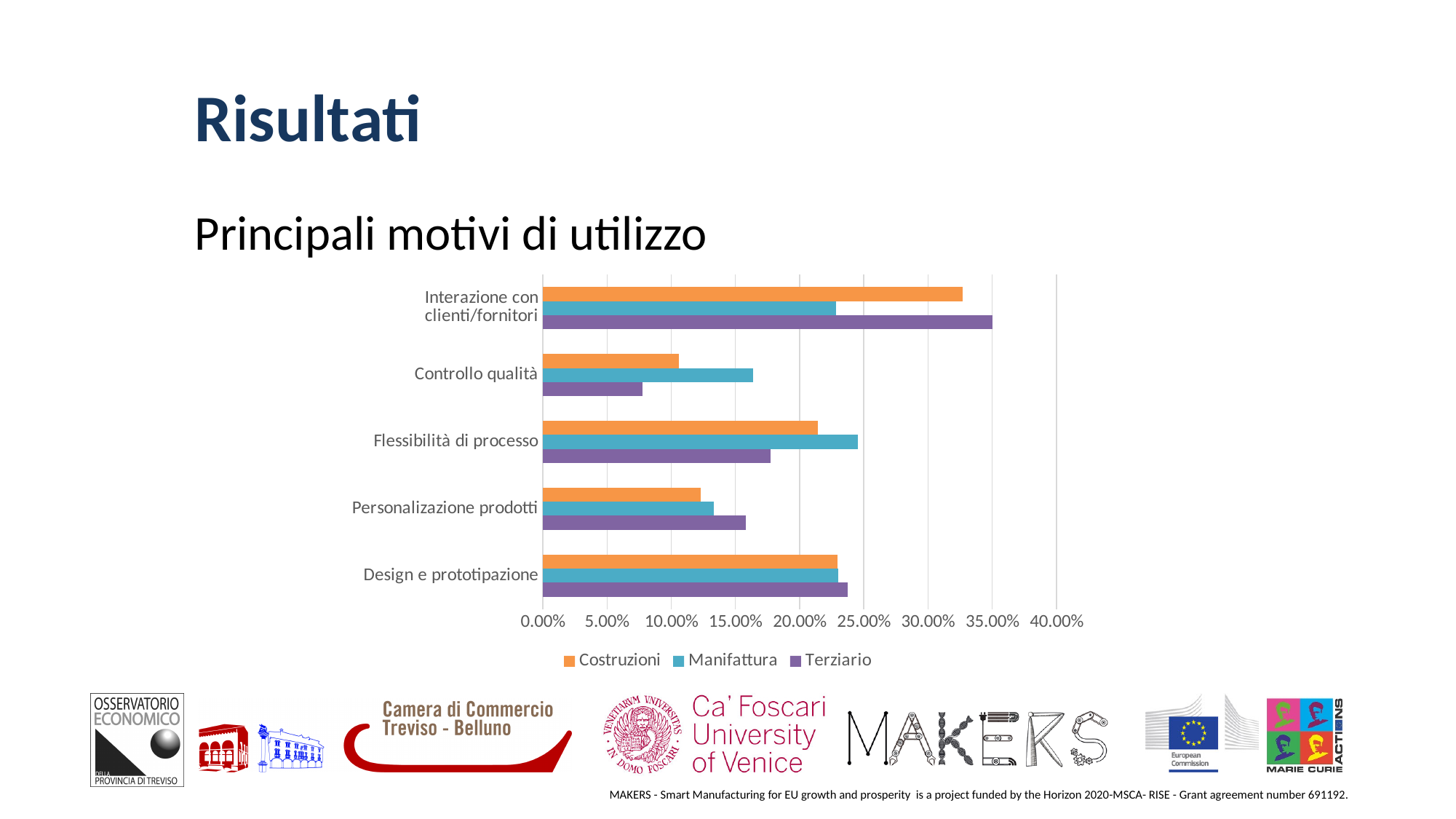
How many categories are shown on the chart? 5 Is the Terziario value for Interazione con clienti/fornitori greater or less than 30.00%? greater How many series does the chart legend list? 3 Which category has the highest value for the Costruzioni series? Interazione con clienti/fornitori Which colour represents the Costruzioni series in the chart? orange Which category has the lowest value for the Terziario series? Controllo qualità Is the Terziario value for Controllo qualità greater or less than 10.00%? less What kind of chart is shown on the slide? bar chart For Controllo qualità, which series has the larger value, Costruzioni or Manifattura? Manifattura For Flessibilità di processo, which series has the larger value, Manifattura or Terziario? Manifattura Which category has the lowest value for the Costruzioni series? Controllo qualità Which category has the highest value for the Terziario series? Interazione con clienti/fornitori